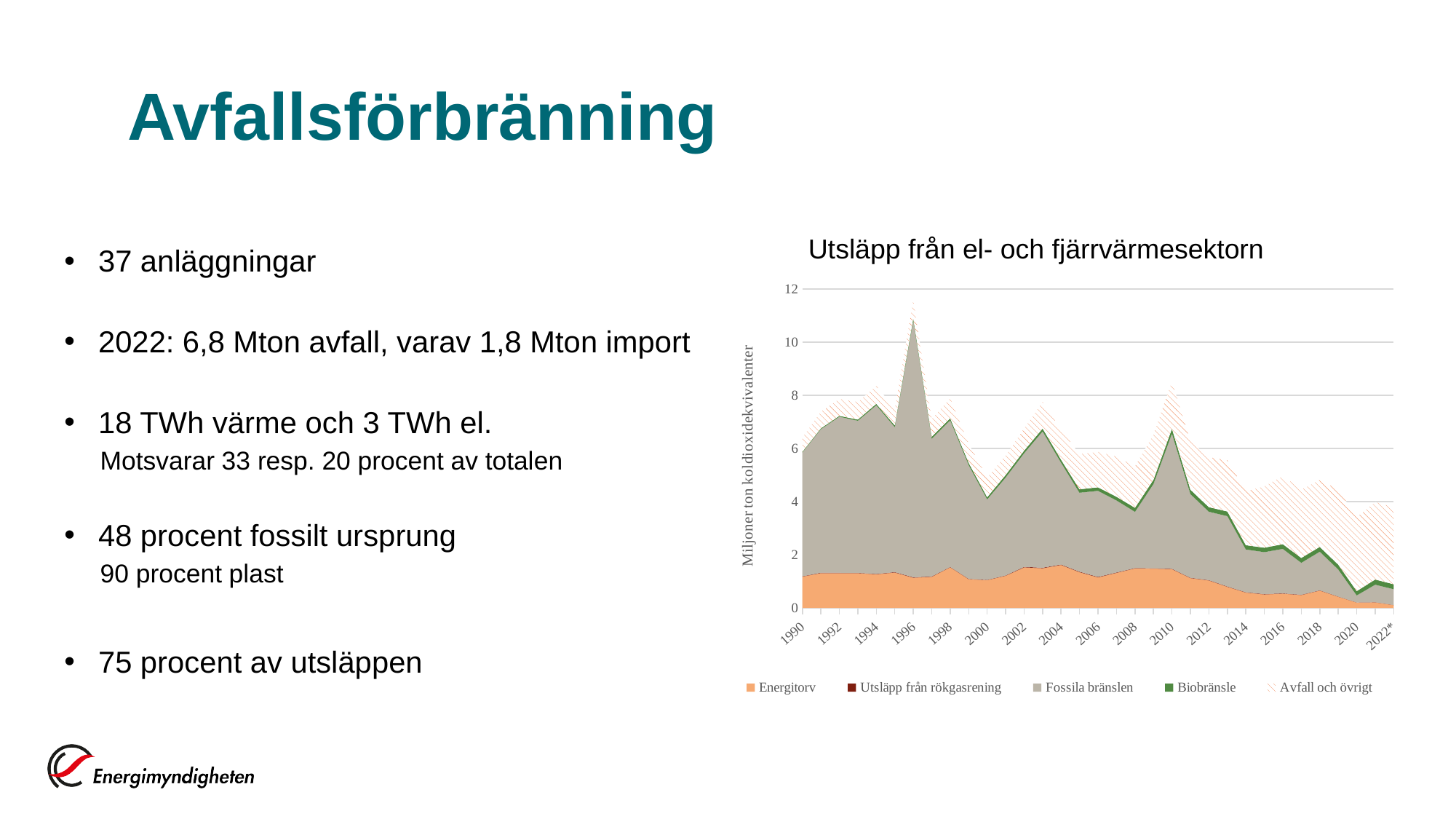
Is the total value for 1996 greater or less than 10? greater In which year does the total emissions in the chart reach its highest point? 1996 What is the title of the chart on the slide? Utsläpp från el- och fjärrvärmesektorn Is the total value for 2022* greater or less than 6? less Is the total value for 2010 greater or less than 6? greater How many year labels are shown on the x axis of the chart? 17 What kind of chart is shown on the slide? Stacked area chart Do total emissions in the chart generally rise or fall from 1990 to 2022*? fall Which year has a larger total value, 1996 or 2010? 1996 How many series does the chart's legend list? 5 What is the label on the vertical axis of the chart? Miljoner ton koldioxidekvivalenter